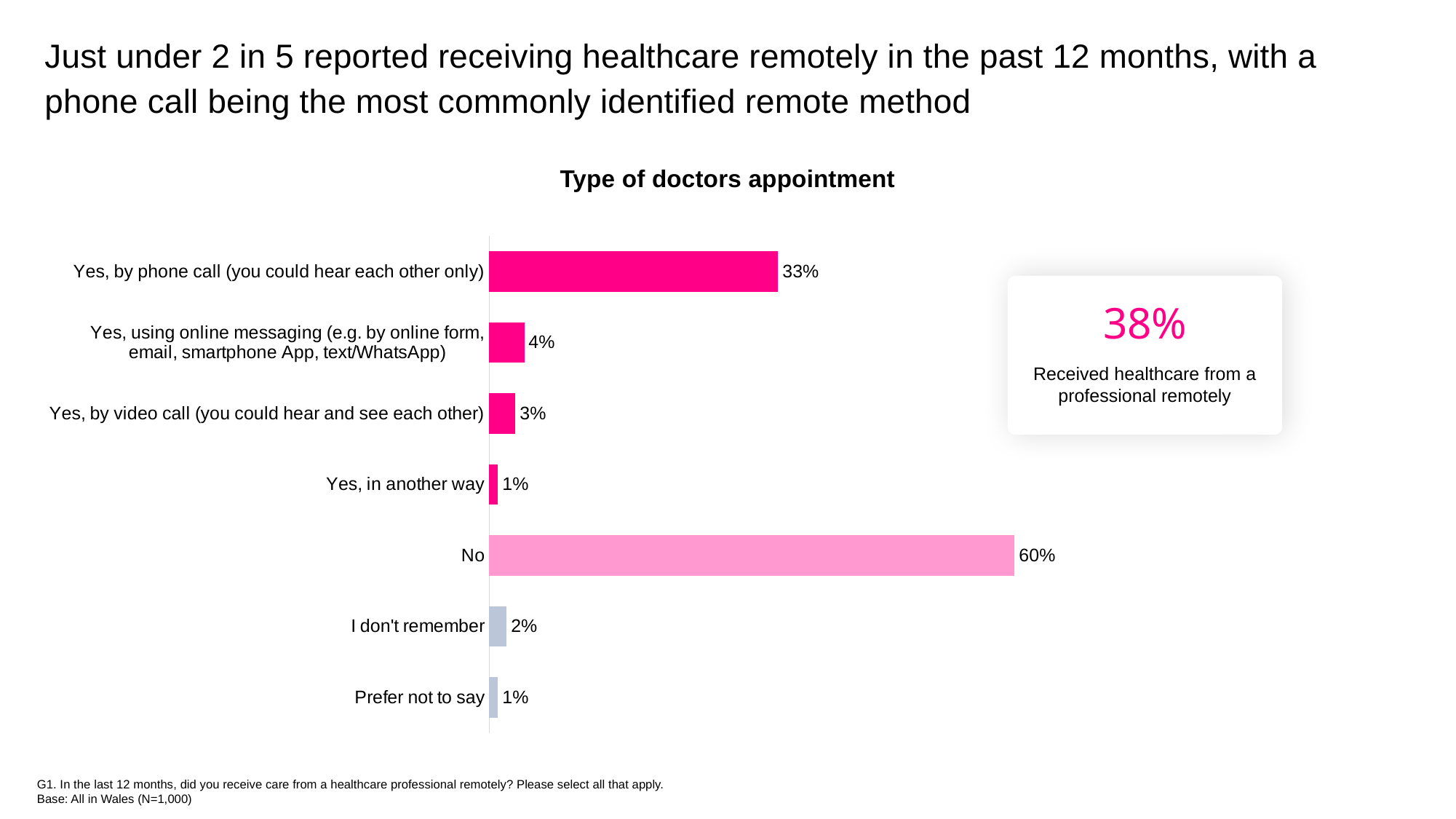
What is the title of the chart? Type of doctors appointment What percentage reported using online messaging? 4% What percentage reported receiving healthcare by phone call? 33% What is the difference between the 'No' value and the 'Yes, by phone call' value? 27% Which is larger: the value for online messaging or the value for video call? Online messaging What kind of chart is shown on the slide? Bar chart What percentage said 'I don't remember'? 2% What percentage is shown in the callout box as having received healthcare from a professional remotely? 38% What is the value for 'No' in the Type of doctors appointment chart? 60% What is the value for 'Yes, by video call'? 3% How many categories are shown in the chart? 7 Which category has the highest value in the chart? No